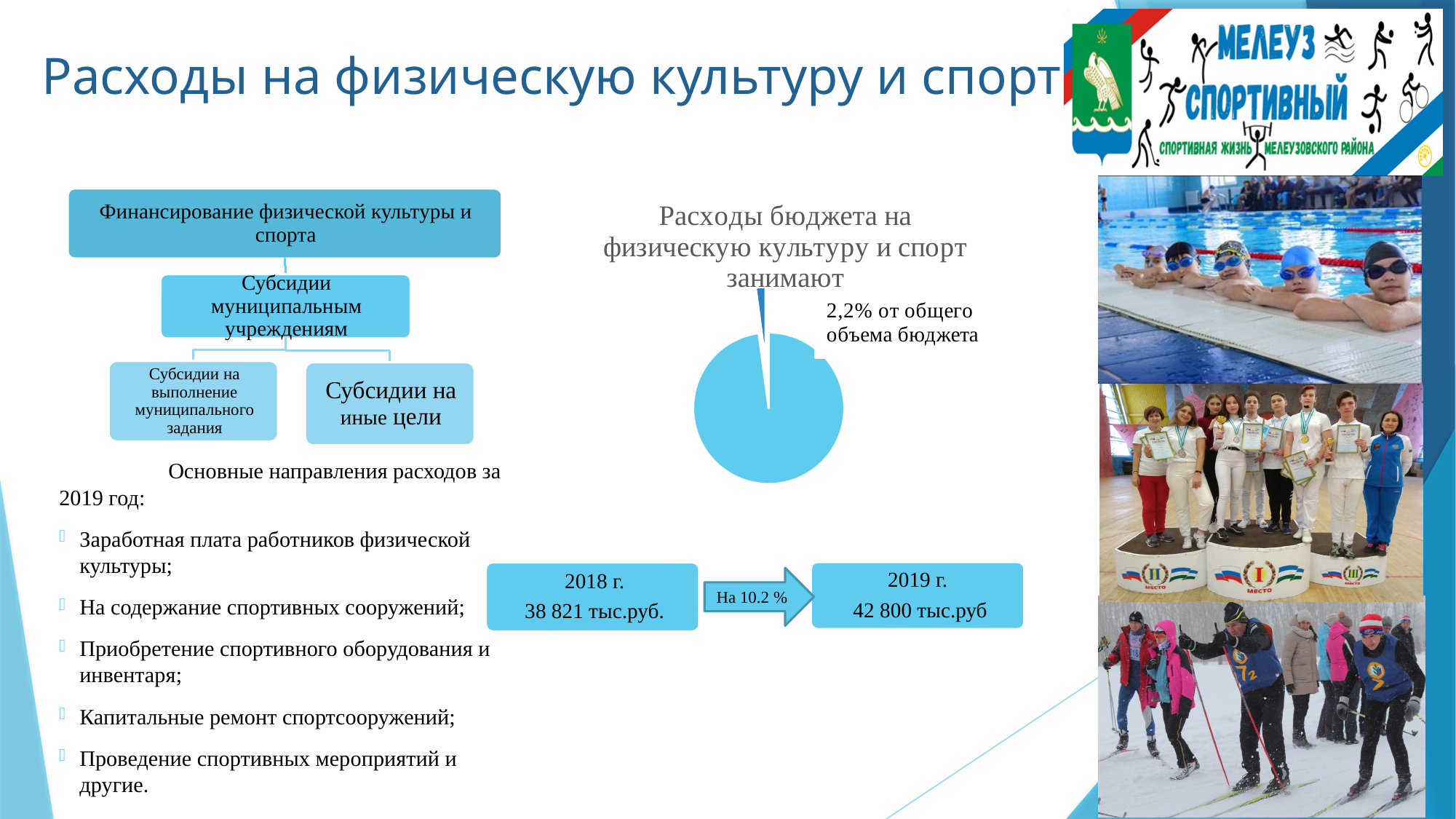
What colour are the slices of the pie chart? blue What kind of chart is shown under the heading "Расходы бюджета на физическую культуру и спорт занимают"? pie chart Is the slice labeled "2,2% от общего объема бюджета" the larger or the smaller slice of the pie chart? smaller How many slices does the pie chart have? 2 What share of the total budget do expenditures on physical culture and sport occupy, according to the pie chart label? 2,2% What is the title of the pie chart? Расходы бюджета на физическую культуру и спорт занимают Is the share of the budget spent on physical culture and sport, as shown in the pie chart, greater or less than 50%? less